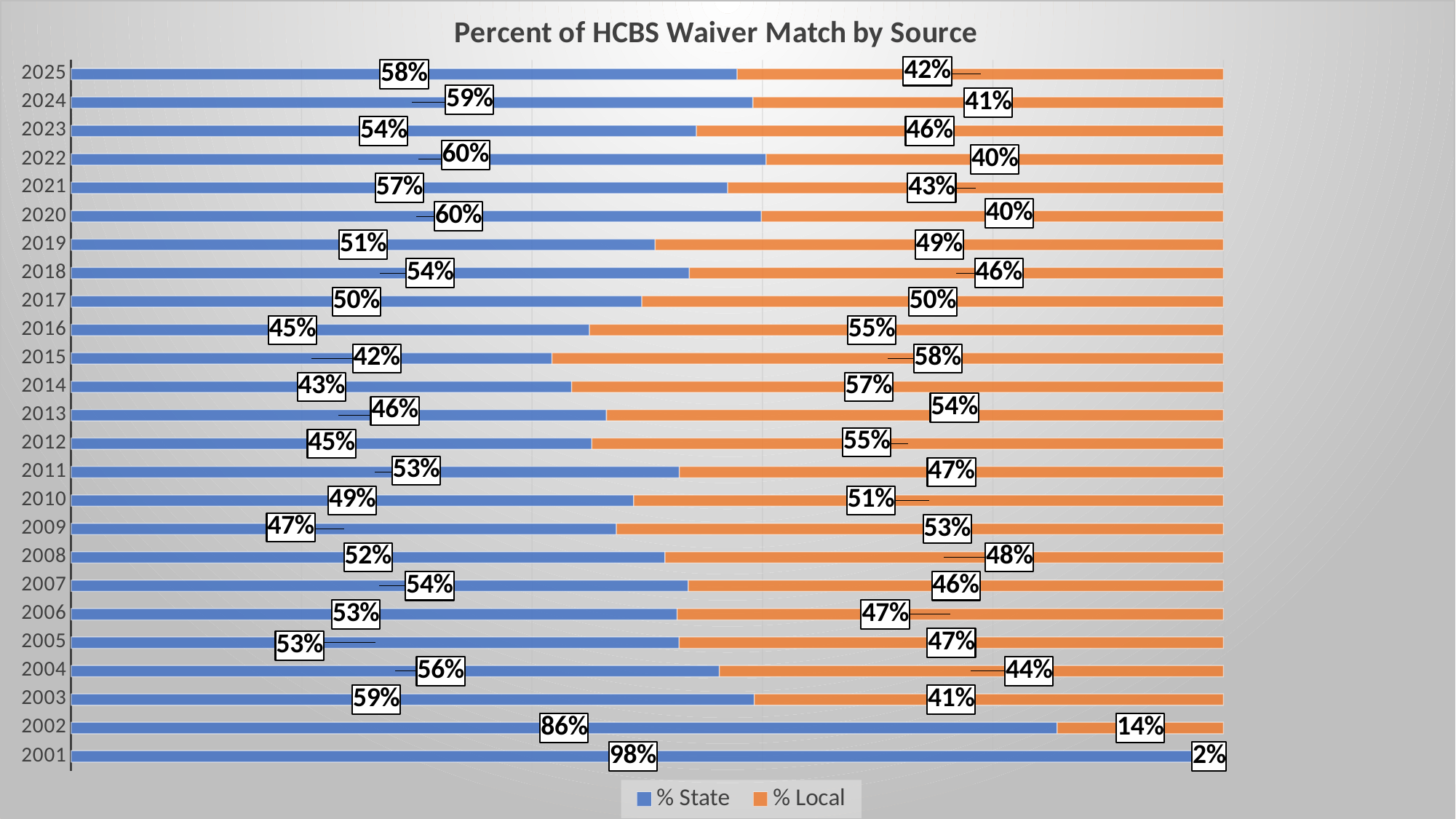
How many years are shown on the chart? 25 What kind of chart is shown on the slide? Stacked bar chart Which year has the highest % State value? 2001 How many series does the legend list? 2 Which year has the lowest % State value? 2015 What is the difference between the % State and % Local values for 2022? 20% What is the % Local value for 2016? 55% What is the % State value for 2025? 58% What is the title of the chart? Percent of HCBS Waiver Match by Source Which year has the lowest % Local value? 2001 What is the % State value for 2002? 86% Is the % State value for 2019 larger than the % State value for 2020? No